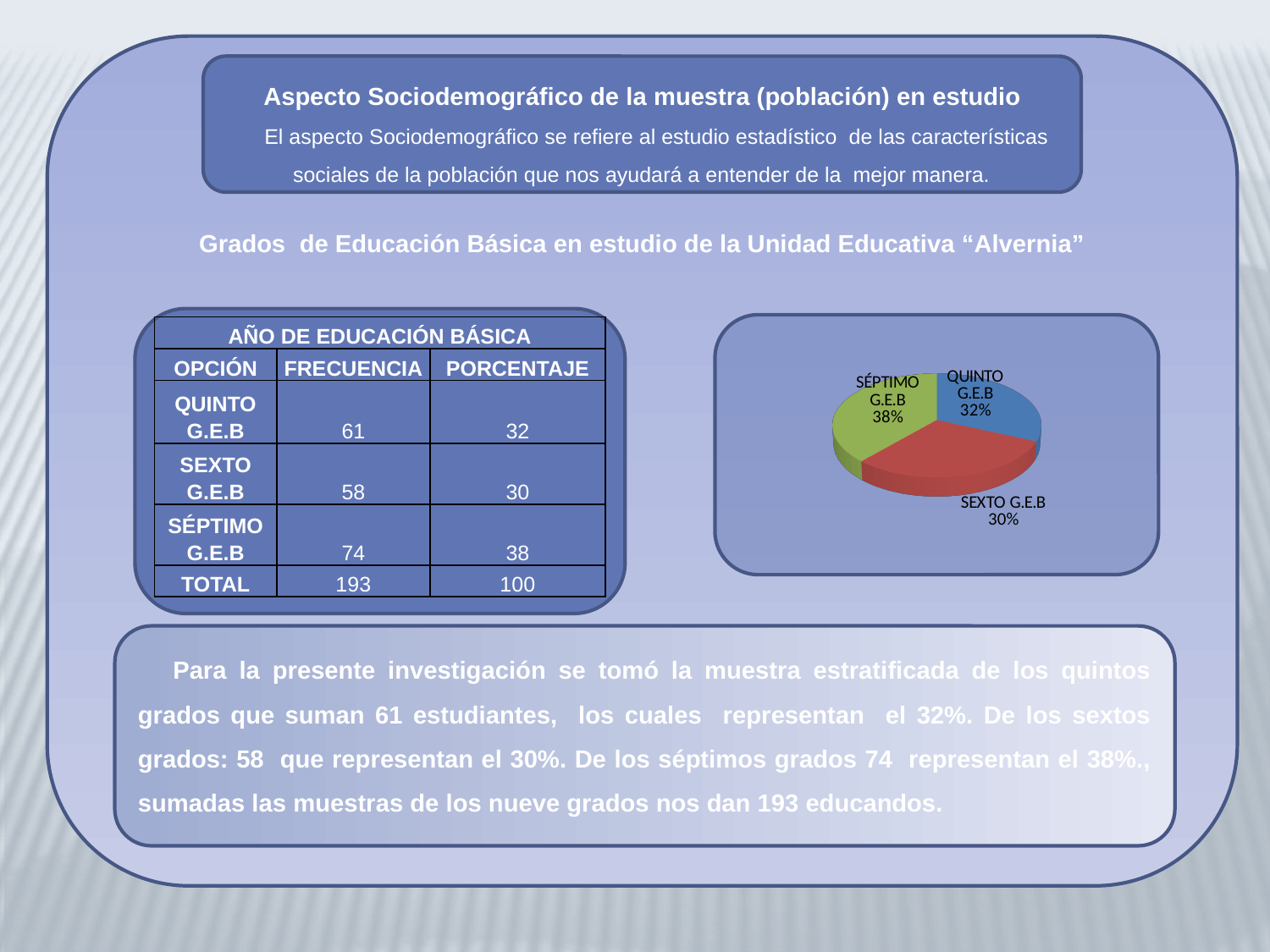
What kind of chart is shown on the slide? pie chart What colour is the SEXTO G.E.B slice of the pie? red What colour is the SÉPTIMO G.E.B slice of the pie? green What share of the pie does SÉPTIMO G.E.B represent? 38% What share of the pie does SEXTO G.E.B represent? 30% What share of the pie does QUINTO G.E.B represent? 32% What is the difference in percentage points between the QUINTO G.E.B slice and the SEXTO G.E.B slice? 2 What is the difference in percentage points between the SÉPTIMO G.E.B slice and the SEXTO G.E.B slice? 8 Which category has the largest slice of the pie? SÉPTIMO G.E.B Which category has the smallest slice of the pie? SEXTO G.E.B Which slice is larger, QUINTO G.E.B or SEXTO G.E.B? QUINTO G.E.B How many slices does the pie chart have? 3